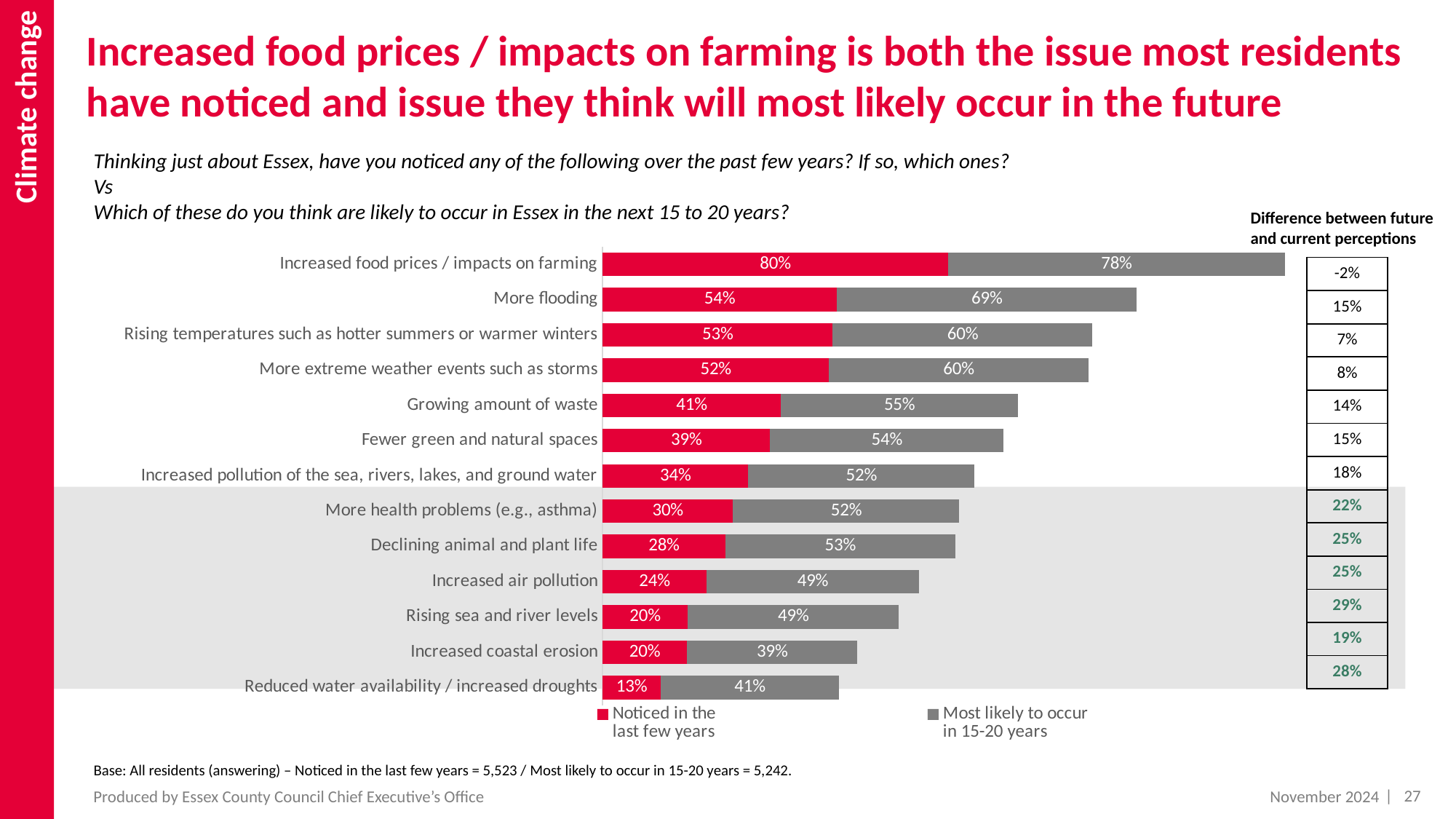
Which category has the highest 'Most likely to occur in 15-20 years' value? Increased food prices / impacts on farming Which colour represents the 'Noticed in the last few years' series? Red What is the difference between the 'Most likely to occur in 15-20 years' and 'Noticed in the last few years' values for more health problems (e.g., asthma)? 22% How many series does the legend list? 2 What kind of chart is shown on the slide? Stacked bar chart What is the 'Noticed in the last few years' value for reduced water availability / increased droughts? 13% Which category has the lowest 'Noticed in the last few years' value? Reduced water availability / increased droughts What percentage of residents think more flooding is most likely to occur in 15-20 years? 69% What percentage of residents noticed increased food prices / impacts on farming in the last few years? 80% What is the total of the stacked bar for increased coastal erosion? 59% Which is larger for growing amount of waste: the 'Noticed in the last few years' value or the 'Most likely to occur in 15-20 years' value? Most likely to occur in 15-20 years How many categories are shown in the chart? 13